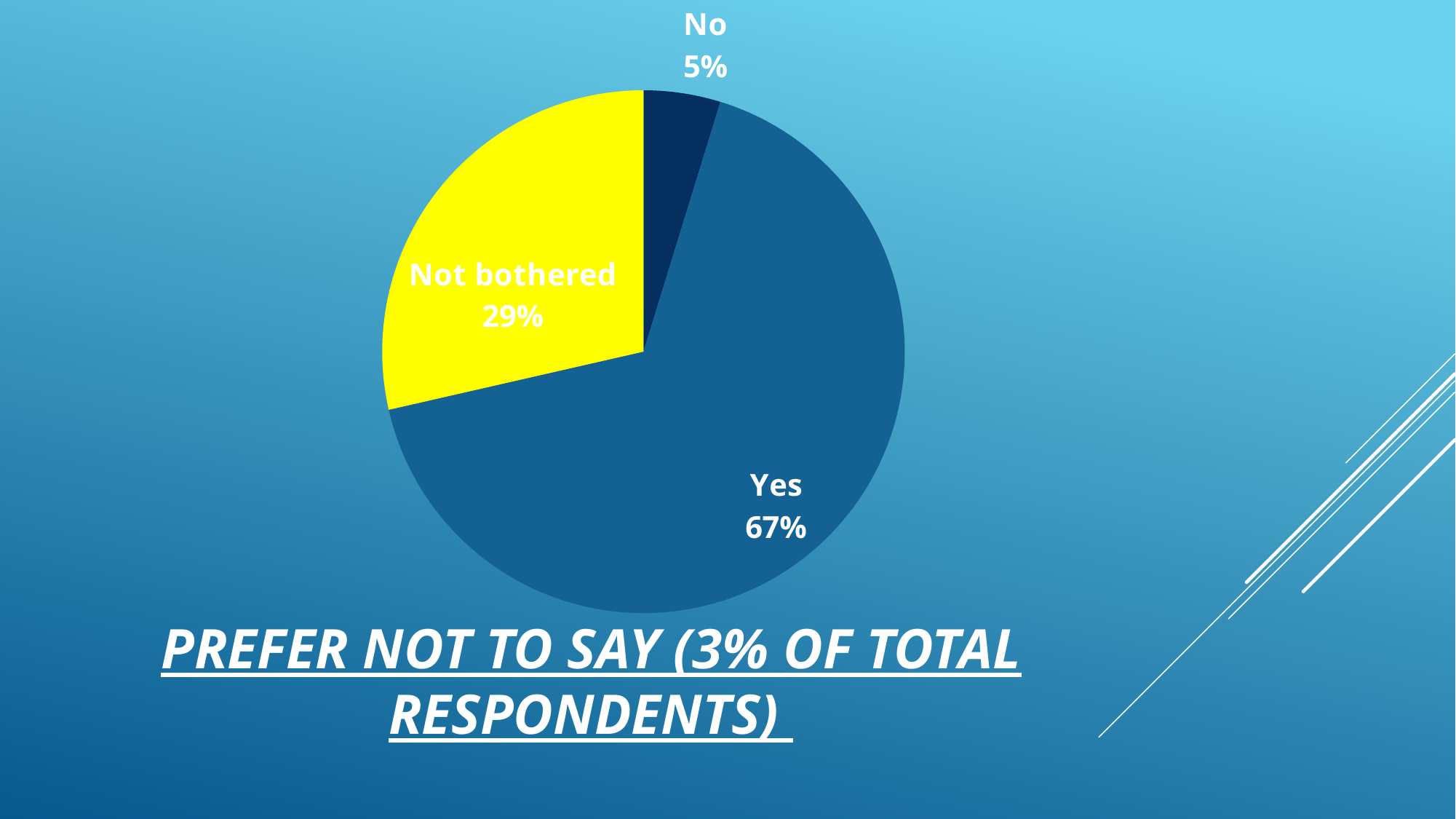
What percentage of the pie is the "No" slice? 5% What is the difference in percentage points between the "Yes" slice and the "Not bothered" slice? 38 How many slices does the pie chart have? 3 Which slice of the pie is the largest? Yes What colour is the "Not bothered" slice? yellow What is the text shown below the pie chart? PREFER NOT TO SAY (3% OF TOTAL RESPONDENTS) Which is larger, the "Not bothered" slice or the "No" slice? Not bothered What is the difference in percentage points between the "Not bothered" slice and the "No" slice? 24 What percentage of the pie is the "Not bothered" slice? 29% What percentage of the pie is the "Yes" slice? 67% Which slice of the pie is the smallest? No What kind of chart is shown on the slide? pie chart